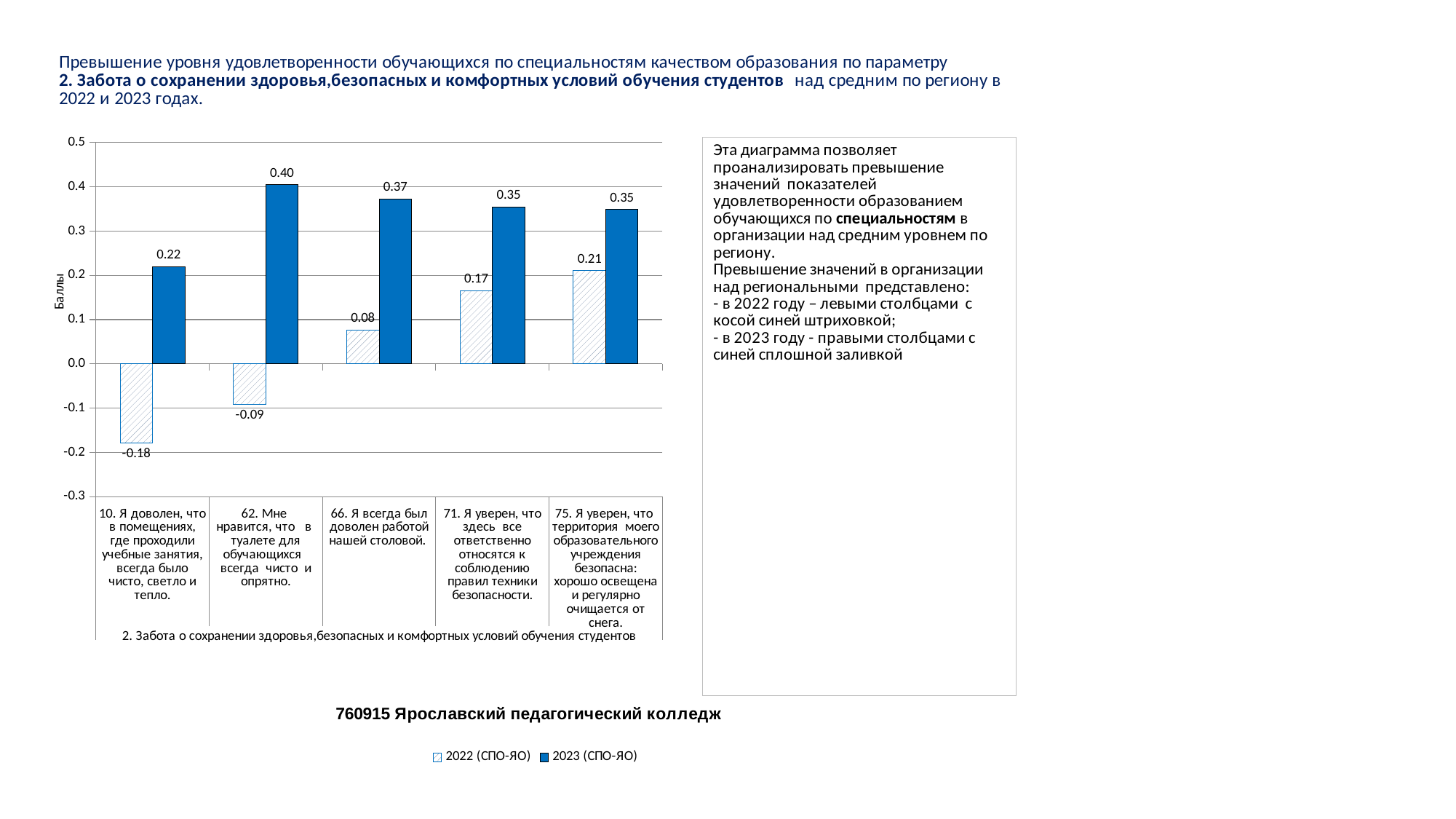
For item 71 (Я уверен, что здесь все ответственно относятся к соблюдению правил техники безопасности), which is larger: the 2022 value or the 2023 value? 2023 (СПО-ЯО) Do the 2022 (СПО-ЯО) values rise or fall from item 10 to item 75 along the x axis? Rise What is the 2022 (СПО-ЯО) value for item 75 (Я уверен, что территория моего образовательного учреждения безопасна)? 0.21 What is the difference between the 2023 and 2022 values for item 66 (Я всегда был доволен работой нашей столовой)? 0.29 Which item has the lowest 2022 (СПО-ЯО) value? 10. Я доволен, что в помещениях, где проходили учебные занятия, всегда было чисто, светло и тепло. What type of chart is shown on the slide? Bar chart Which item has the highest 2023 (СПО-ЯО) value? 62. Мне нравится, что в туалете для обучающихся всегда чисто и опрятно. How many series does the chart legend list? 2 What is the 2022 (СПО-ЯО) value for item 10 (Я доволен, что в помещениях, где проходили учебные занятия, всегда было чисто, светло и тепло)? -0.18 What is the 2023 (СПО-ЯО) value for item 62 (Мне нравится, что в туалете для обучающихся всегда чисто и опрятно)? 0.40 How many items (categories) are shown on the x axis of the chart? 5 What is the label of the vertical axis of the chart? Баллы